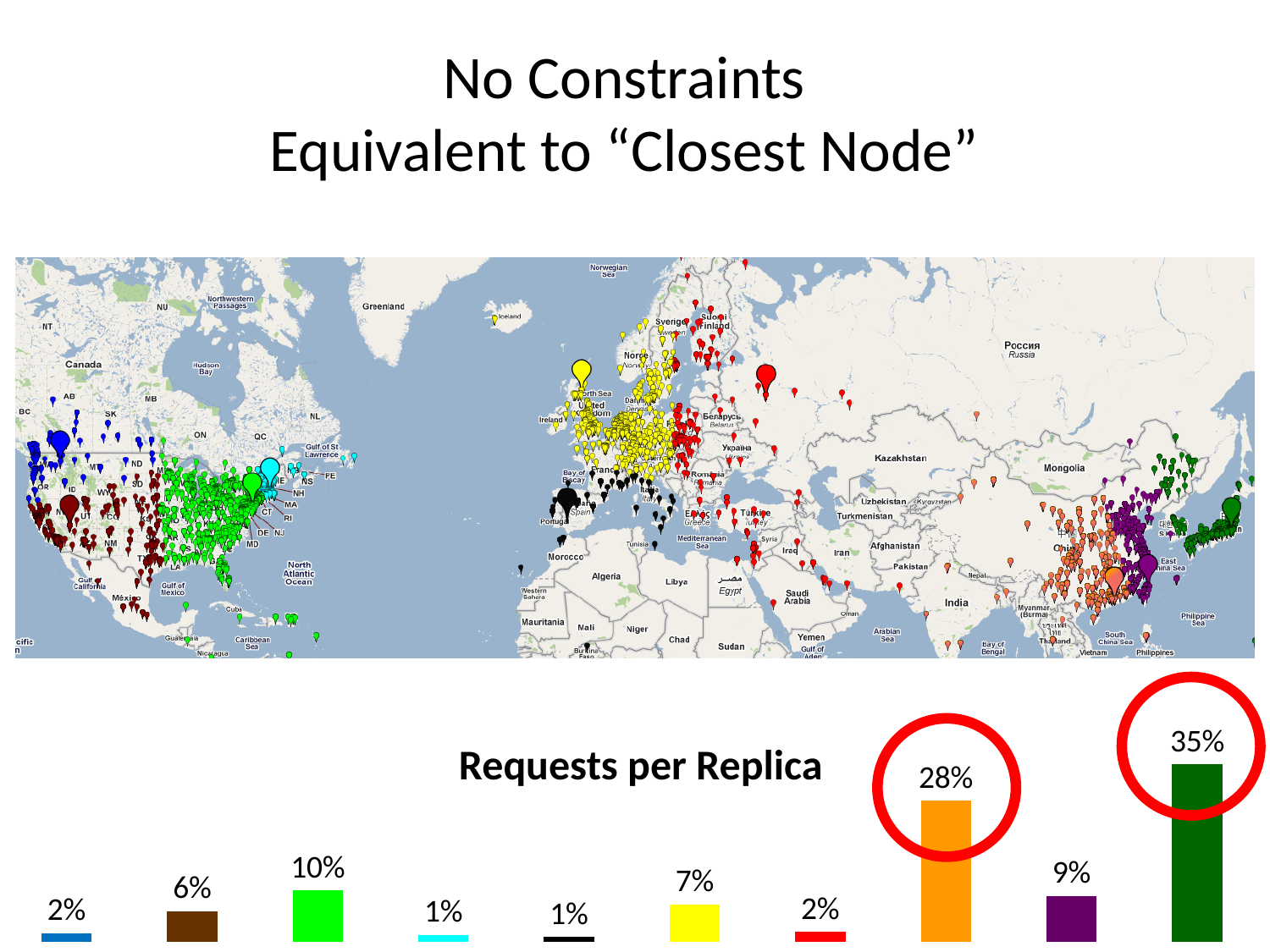
In the Requests per Replica chart, what value is shown for the purple bar? 9% What kind of chart is the Requests per Replica chart? bar chart In the Requests per Replica chart, how many bars are circled in red? 2 In the Requests per Replica chart, what is the difference between the dark green bar and the orange bar? 7% In the Requests per Replica chart, what is the difference between the bright green bar and the purple bar? 1% What is the title of the bar chart at the bottom of the slide? Requests per Replica In the Requests per Replica chart, which is larger, the yellow bar or the brown bar? the yellow bar (7%) In the Requests per Replica chart, which bar has the highest value? the dark green bar (35%) In the Requests per Replica chart, what value is shown for the orange bar? 28% In the Requests per Replica chart, what value is shown for the dark green bar at the far right? 35% In the Requests per Replica chart, what value is shown for the bright green bar (third from the left)? 10% How many bars are shown in the Requests per Replica chart? 10